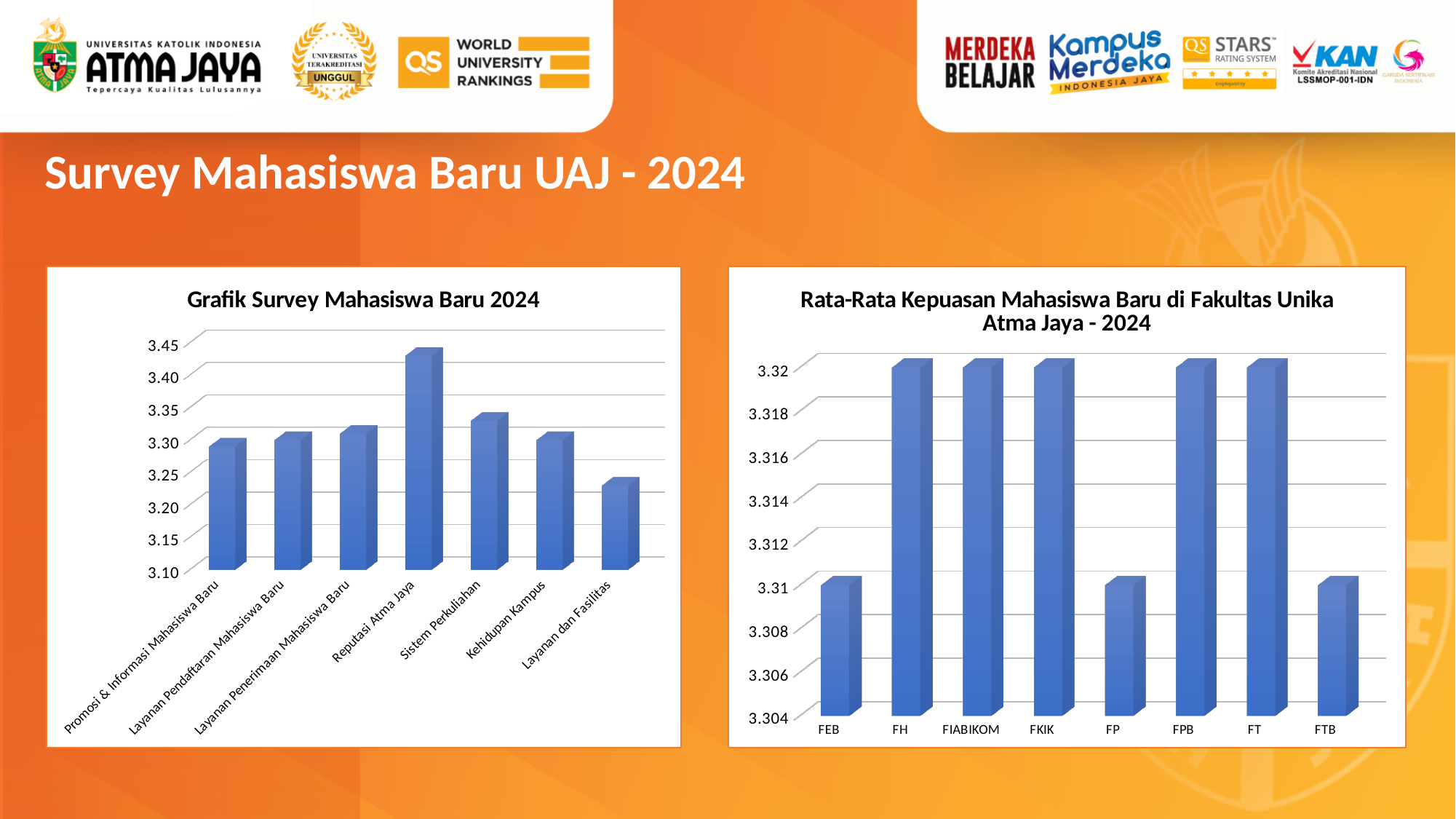
On the right chart, which is larger: FH or FP? FH How many categories are shown on the left chart? 7 On the left chart, which category has the lowest value? Layanan dan Fasilitas What is the title of the left chart? Grafik Survey Mahasiswa Baru 2024 On the left chart, is the value for Reputasi Atma Jaya greater or less than 3.40? greater On the left chart, which category has the highest value? Reputasi Atma Jaya On the right chart, is the value for FH greater or less than 3.318? greater How many faculties are shown on the right chart? 8 What kind of chart is the left chart? bar chart On the left chart, which is larger: Reputasi Atma Jaya or Sistem Perkuliahan? Reputasi Atma Jaya On the left chart, is the value for Layanan dan Fasilitas greater or less than 3.25? less